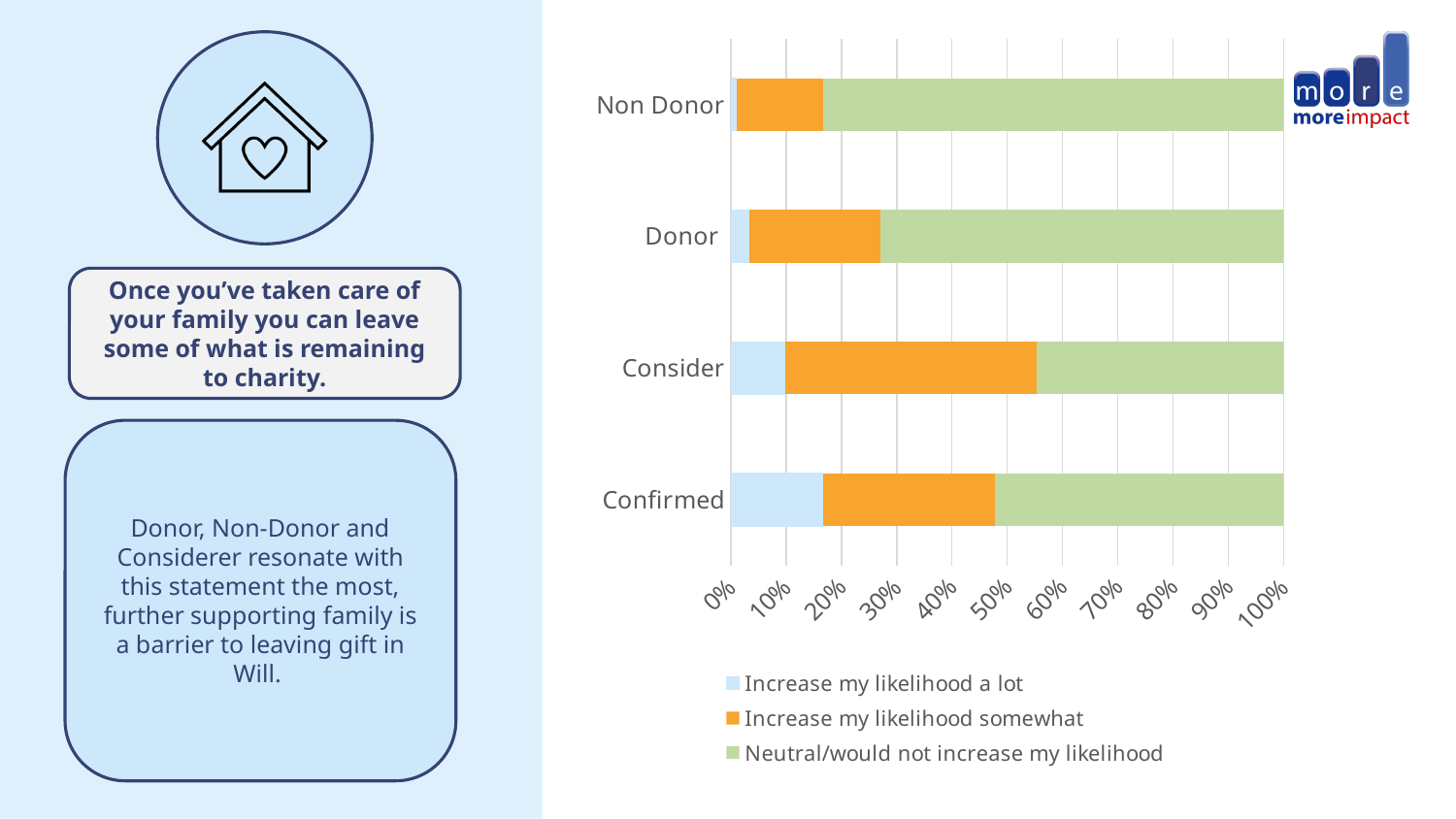
How many series does the chart's legend list? 3 Which category has the largest 'Increase my likelihood somewhat' segment? Consider Is the 'Increase my likelihood a lot' value for Donor greater or less than 10%? less Is the 'Increase my likelihood a lot' value for Confirmed greater or less than 10%? greater What colour represents the 'Neutral/would not increase my likelihood' series in the chart? Green How many categories are shown on the chart's vertical axis? 4 Which has the larger 'Increase my likelihood somewhat' segment, Consider or Confirmed? Consider Which category has the largest 'Neutral/would not increase my likelihood' segment? Non Donor Which category has the smallest 'Increase my likelihood somewhat' segment? Non Donor Is the 'Increase my likelihood somewhat' value for Consider greater or less than 40%? greater What kind of chart is shown on the slide? Stacked bar chart Which category has the largest 'Increase my likelihood a lot' segment? Confirmed